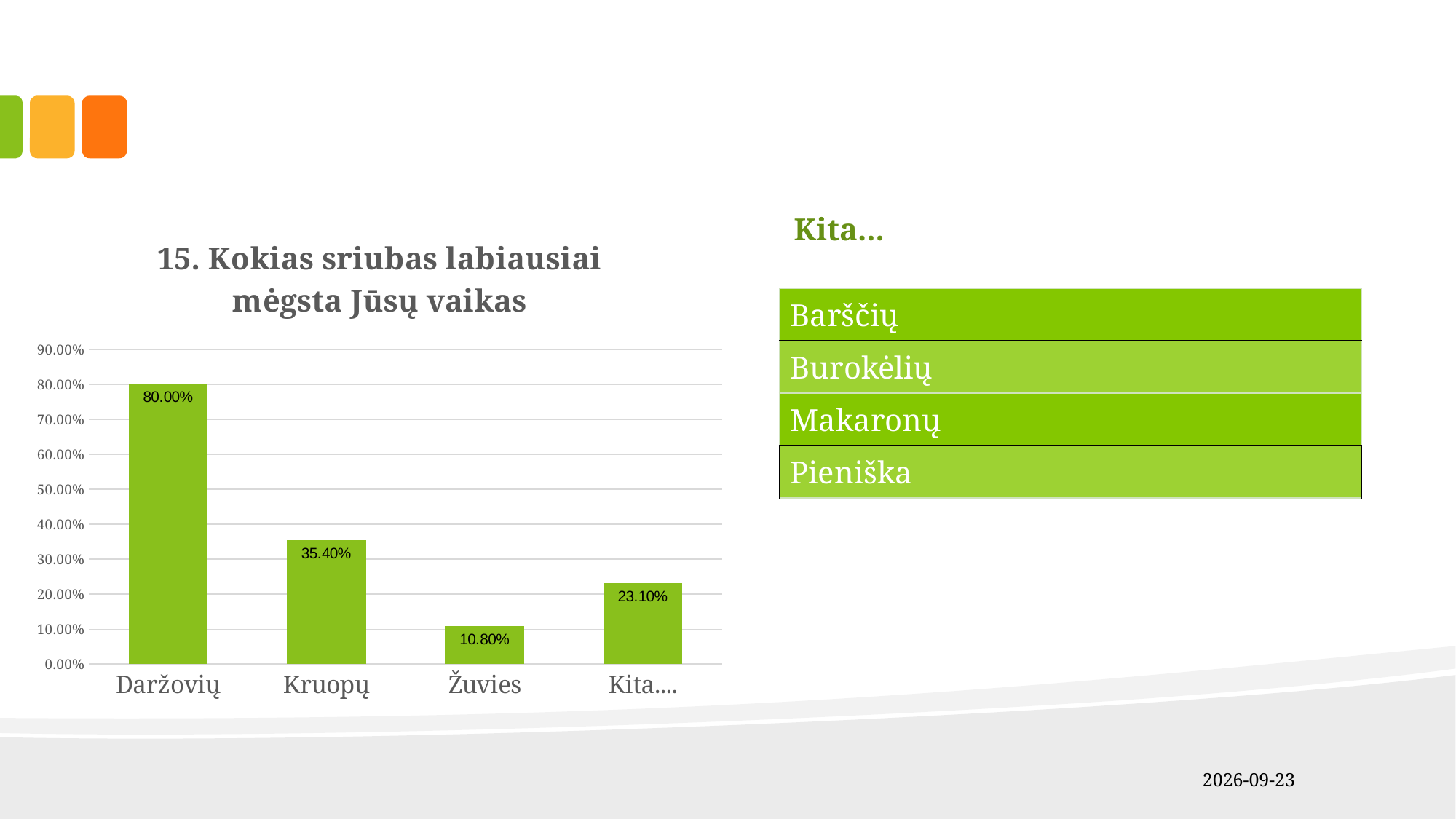
Which category has the highest value? Daržovių What is the value for Kita....? 23.10% What kind of chart is shown on the slide? Bar chart What is the value for Žuvies? 10.80% Is the value for Kruopų greater or less than 30.00%? greater Which category has the lowest value? Žuvies What is the value for Kruopų? 35.40% Which is larger, the value for Kruopų or the value for Kita....? Kruopų How many categories are shown on the x axis? 4 What is the value for Daržovių? 80.00% What is the difference between the values for Kita.... and Žuvies? 12.30% What is the difference between the values for Daržovių and Kruopų? 44.60%